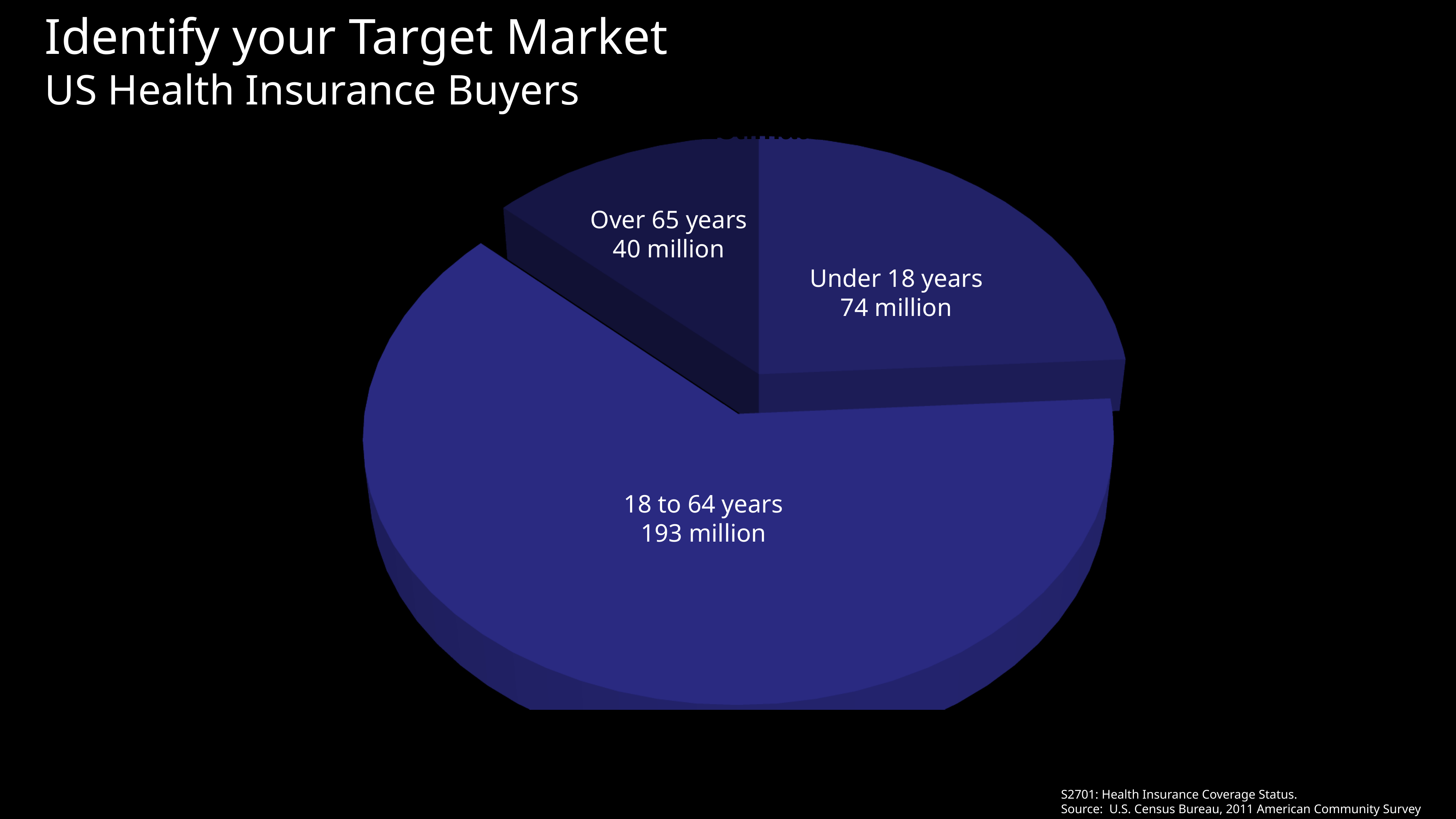
Which age group has the smallest slice? Over 65 years Which slice is pulled out (exploded) from the rest of the pie? 18 to 64 years What is the value for the Under 18 years slice? 74 million Which is larger, the Under 18 years slice or the Over 65 years slice? Under 18 years What kind of chart is shown on the slide? pie chart What is the difference between the 18 to 64 years and Under 18 years values? 119 million What is the total of all three slices? 307 million What is the difference between the Under 18 years and Over 65 years values? 34 million What is the value for the 18 to 64 years slice? 193 million How many slices does the pie chart have? 3 What is the value for the Over 65 years slice? 40 million Which age group has the largest slice? 18 to 64 years